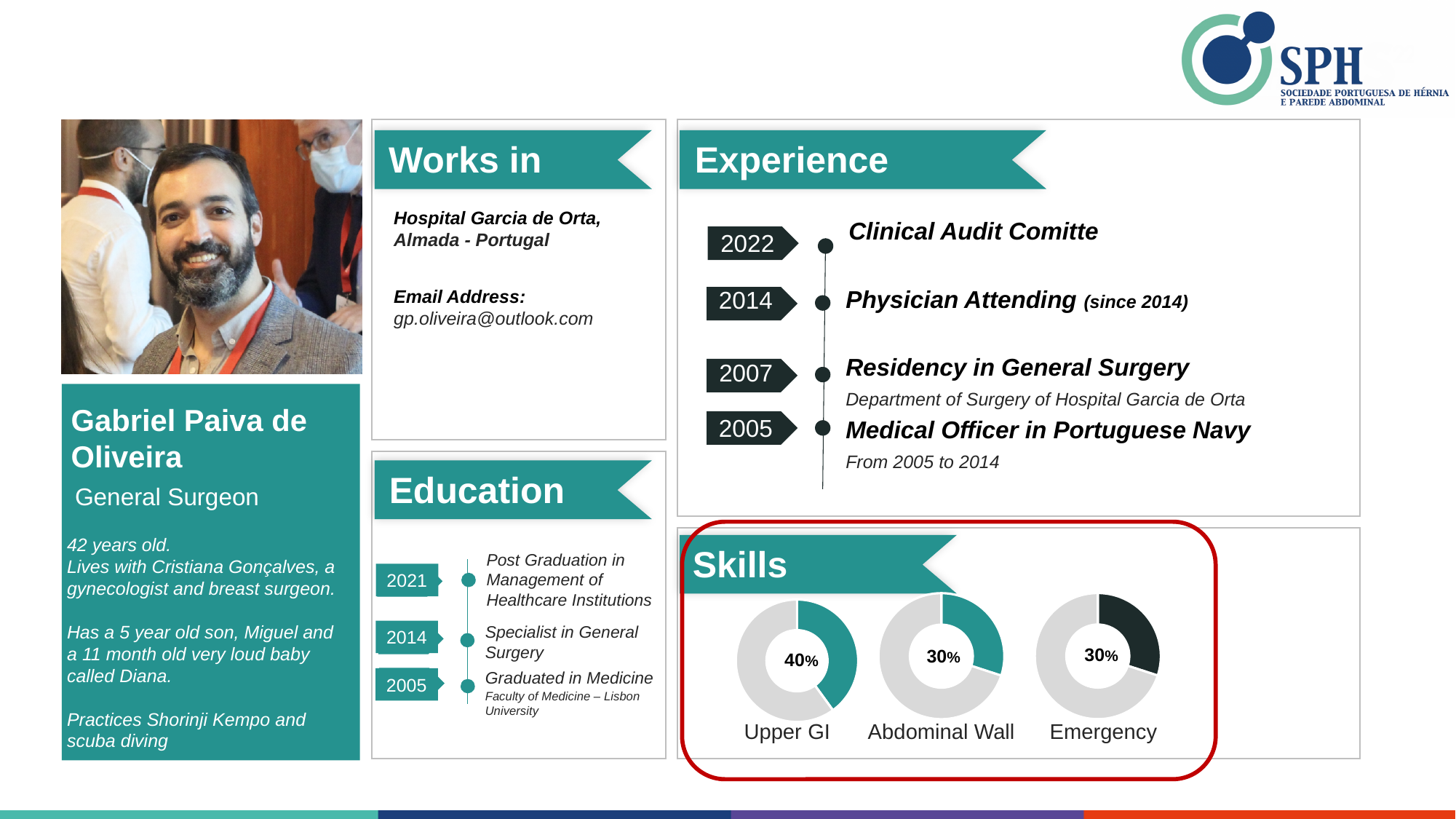
How many skill charts are shown in the Skills section? 3 Among the three Skills charts, which skill has the highest value? Upper GI In the Skills section, what value is shown for Emergency? 30% What is the difference between the Upper GI value and the Abdominal Wall value in the Skills section? 10% In the Skills section, what is the title of the section containing the three charts? Skills What kind of chart is used for each skill in the Skills section? Doughnut chart In the Skills section, what value is shown for Upper GI? 40% In the Skills section, do Abdominal Wall and Emergency have the same value? Yes In the Skills section, which chart uses a dark (near-black) colour for its filled segment? Emergency In the Skills section, which is larger: the value for Upper GI or the value for Emergency? Upper GI In the Skills section, what value is shown for Abdominal Wall? 30%